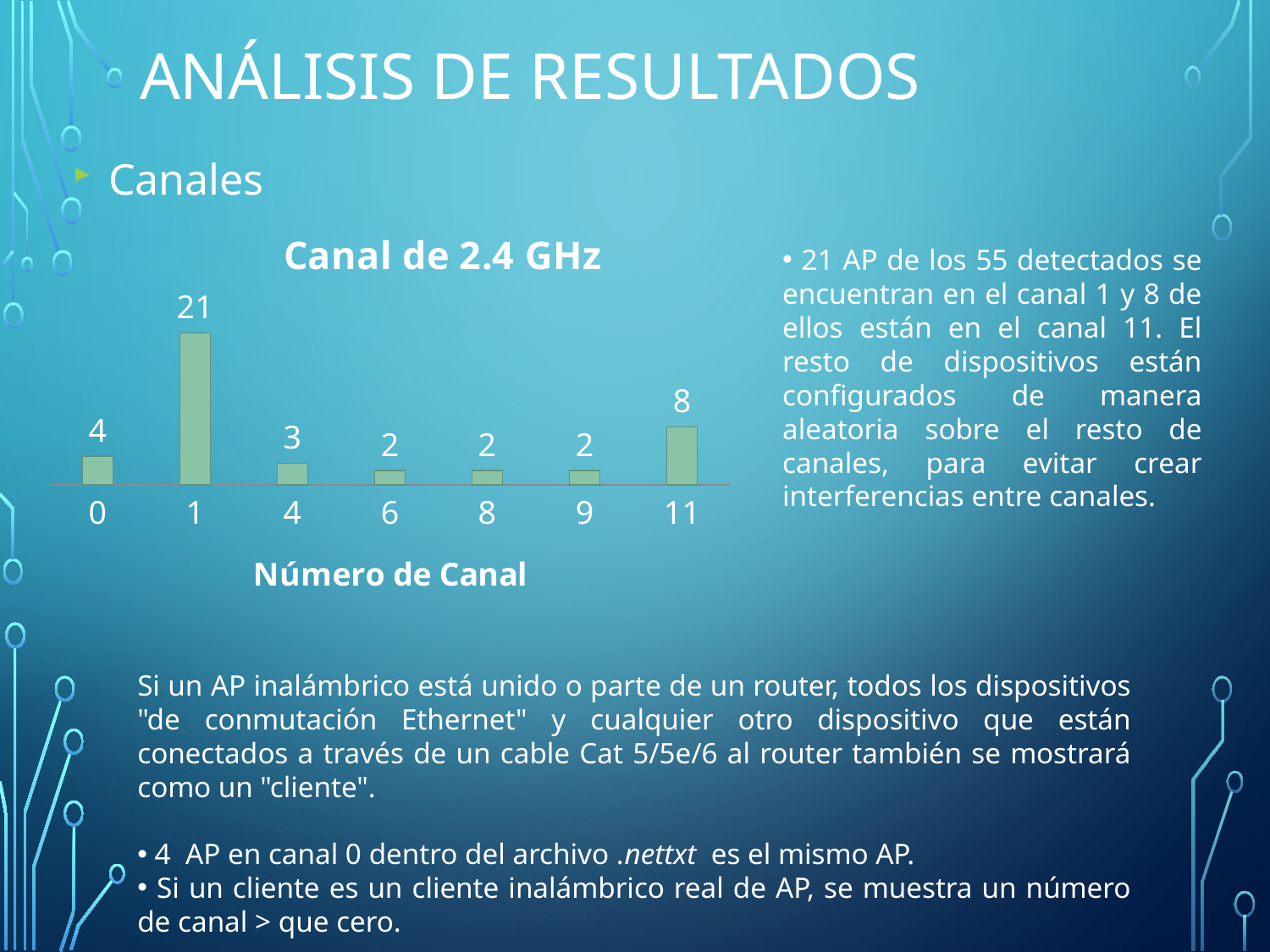
What is the total of all values shown in the 'Canal de 2.4 GHz' chart? 42 What is the value for channel 1 in the 'Canal de 2.4 GHz' chart? 21 Which has a larger value in the 'Canal de 2.4 GHz' chart, channel 0 or channel 11? 11 What is the value for channel 4 in the 'Canal de 2.4 GHz' chart? 3 Which channel has the highest value in the 'Canal de 2.4 GHz' chart? 1 What is the x-axis title of the 'Canal de 2.4 GHz' chart? Número de Canal What is the value for channel 0 in the 'Canal de 2.4 GHz' chart? 4 What kind of chart is the 'Canal de 2.4 GHz' chart? bar chart What is the value for channel 11 in the 'Canal de 2.4 GHz' chart? 8 What is the difference between the values for channel 1 and channel 11 in the 'Canal de 2.4 GHz' chart? 13 How many channel categories are shown in the 'Canal de 2.4 GHz' chart? 7 How many channels have a value of 2 in the 'Canal de 2.4 GHz' chart? 3